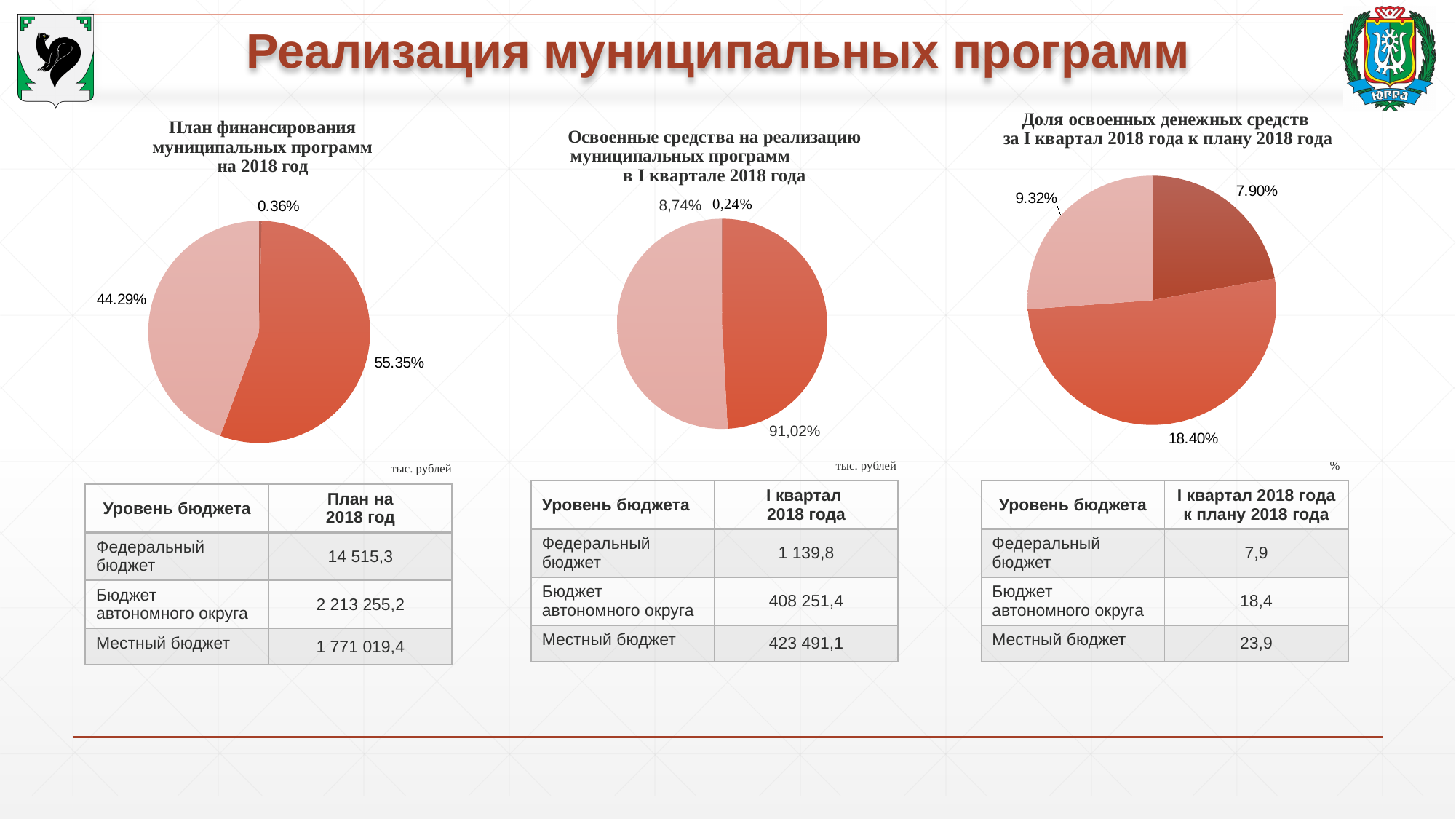
In the chart 'Освоенные средства на реализацию муниципальных программ в I квартале 2018 года', what is the value of the largest slice? 91,02% In the chart 'Доля освоенных денежных средств за I квартал 2018 года к плану 2018 года', what is the value of the largest slice? 18.40% In the chart 'Освоенные средства на реализацию муниципальных программ в I квартале 2018 года', what is the value of the smallest slice? 0,24% How many slices does the pie chart 'План финансирования муниципальных программ на 2018 год' have? 3 What type of chart is used for 'План финансирования муниципальных программ на 2018 год'? pie chart How many pie charts are shown on the slide? 3 In the chart 'План финансирования муниципальных программ на 2018 год', what is the difference between the 55.35% slice and the 44.29% slice? 11.06% In the chart 'Доля освоенных денежных средств за I квартал 2018 года к плану 2018 года', which is larger: the 9.32% slice or the 7.90% slice? 9.32% In the chart 'Доля освоенных денежных средств за I квартал 2018 года к плану 2018 года', what is the value of the smallest slice? 7.90% In the chart 'План финансирования муниципальных программ на 2018 год', what is the value of the largest slice? 55.35% In the chart 'План финансирования муниципальных программ на 2018 год', what is the value of the smallest slice? 0.36% In the chart 'Освоенные средства на реализацию муниципальных программ в I квартале 2018 года', what is the difference between the 91,02% slice and the 8,74% slice? 82,28%